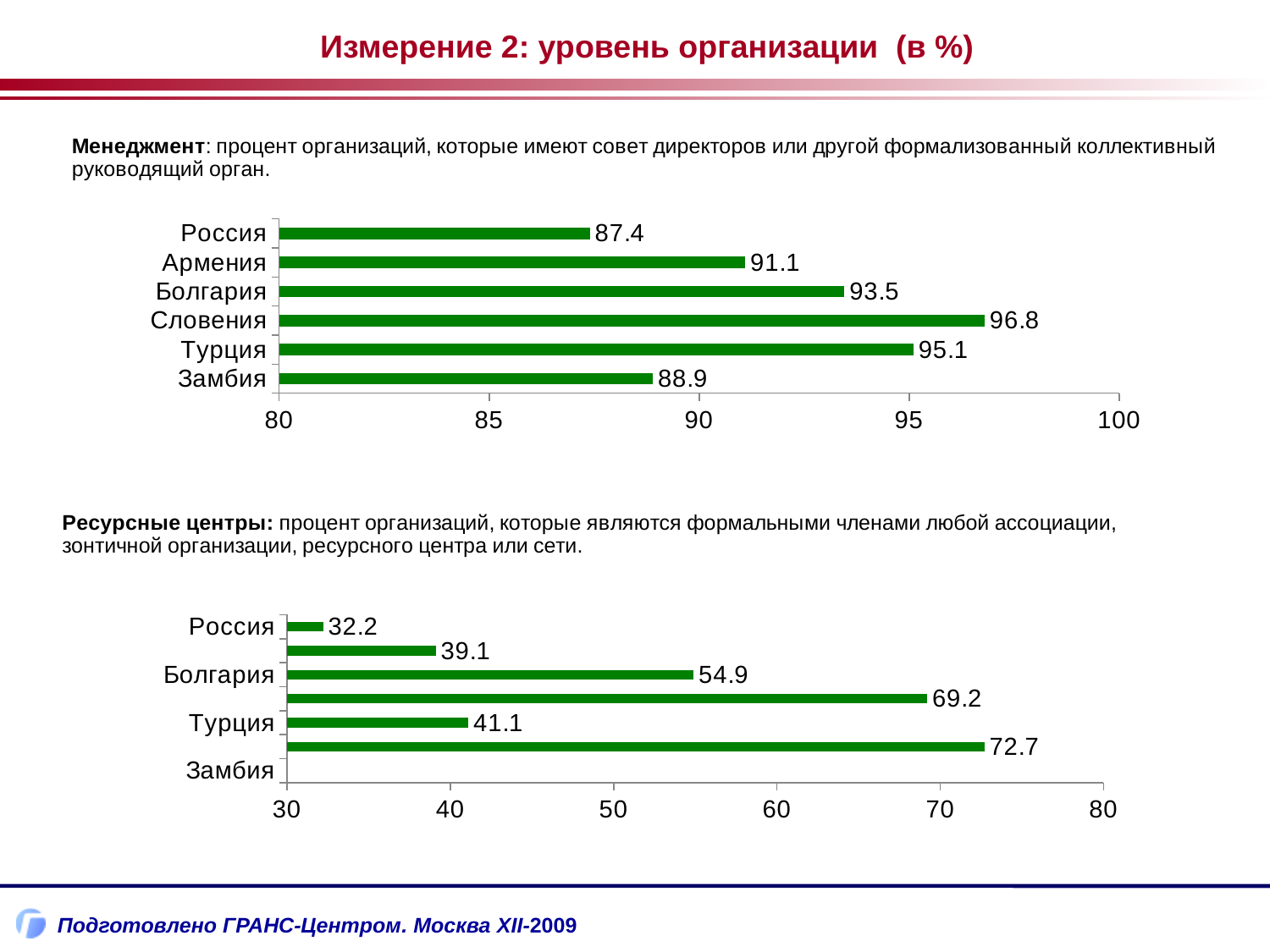
In the top chart (Менеджмент), which country has the highest value? Словения In the top chart (Менеджмент), which is larger, the value for Турция or the value for Болгария? Турция What kind of chart is the top chart (Менеджмент)? Bar chart In the top chart (Менеджмент), what is the difference between the values for Словения and Россия? 9.4 In the top chart (Менеджмент), what is the value for Россия? 87.4 In the top chart (Менеджмент), which country has the lowest value? Россия In the bottom chart (Ресурсные центры), what is the value for Болгария? 54.9 In the bottom chart (Ресурсные центры), what is the value for Россия? 32.2 In the top chart (Менеджмент), how many countries are shown? 6 In the bottom chart (Ресурсные центры), how many bars are plotted? 6 In the top chart (Менеджмент), what is the value for Словения? 96.8 In the bottom chart (Ресурсные центры), what is the highest value shown? 72.7